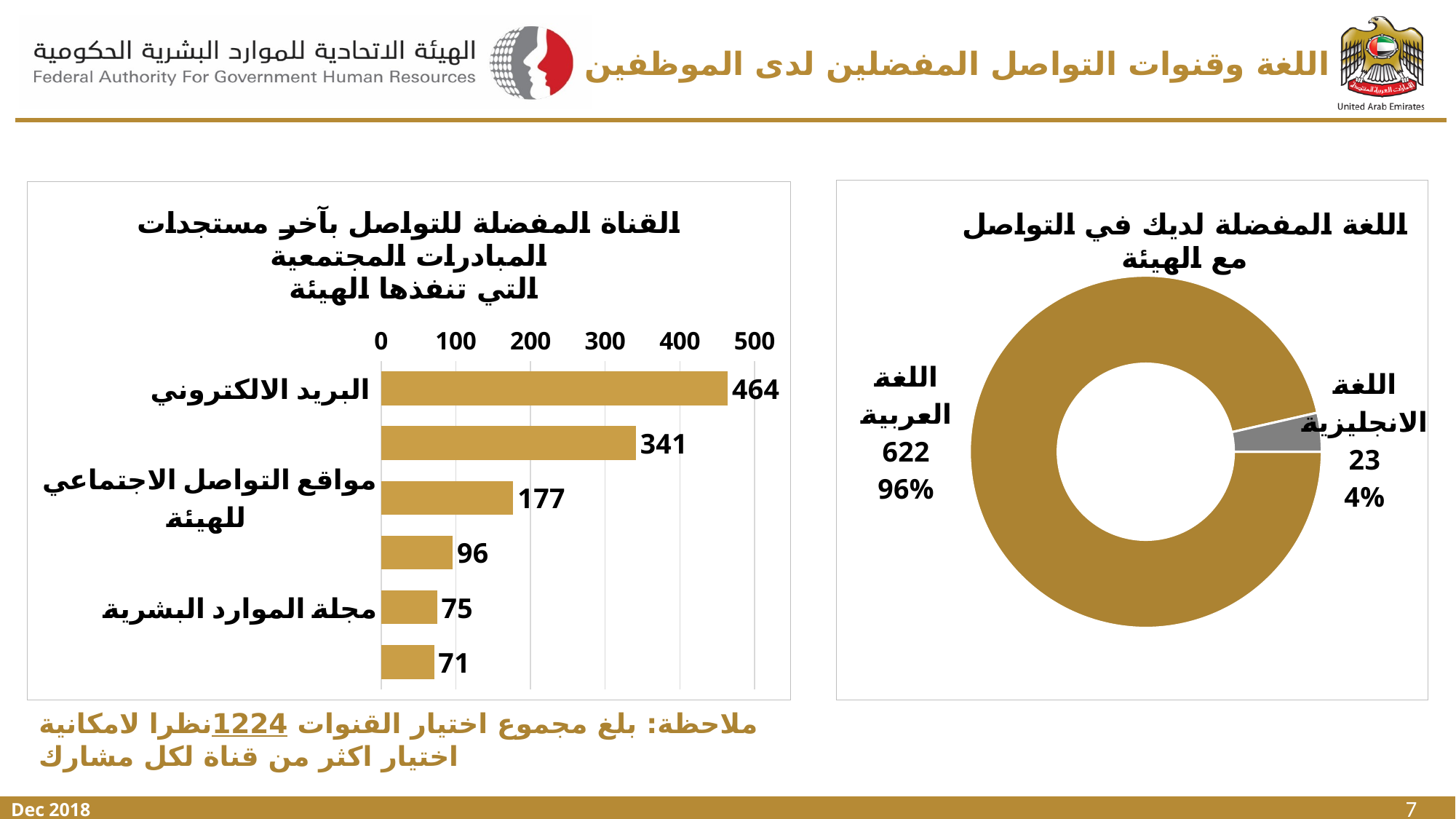
In the right chart (اللغة المفضلة لديك في التواصل مع الهيئة), what is the difference between the values for اللغة العربية and اللغة الانجليزية? 599 In the left chart (القناة المفضلة للتواصل), what is the value for مواقع التواصل الاجتماعي للهيئة? 177 In the left chart (القناة المفضلة للتواصل), what is the value for البريد الالكتروني? 464 What kind of chart is the right chart (اللغة المفضلة لديك في التواصل مع الهيئة)? donut chart How many bars are plotted in the left chart (القناة المفضلة للتواصل)? 6 In the right chart (اللغة المفضلة لديك في التواصل مع الهيئة), what share does اللغة الانجليزية have? 4% In the left chart (القناة المفضلة للتواصل), what is the value for مجلة الموارد البشرية? 75 In the left chart (القناة المفضلة للتواصل), what is the difference between the values for البريد الالكتروني and مجلة الموارد البشرية? 389 In the left chart (القناة المفضلة للتواصل), which category has the highest value? البريد الالكتروني What kind of chart is the left chart (القناة المفضلة للتواصل)? bar chart In the right chart (اللغة المفضلة لديك في التواصل مع الهيئة), what is the value for اللغة العربية? 622 In the left chart (القناة المفضلة للتواصل), which is larger: the value for مواقع التواصل الاجتماعي للهيئة or the value for مجلة الموارد البشرية? مواقع التواصل الاجتماعي للهيئة